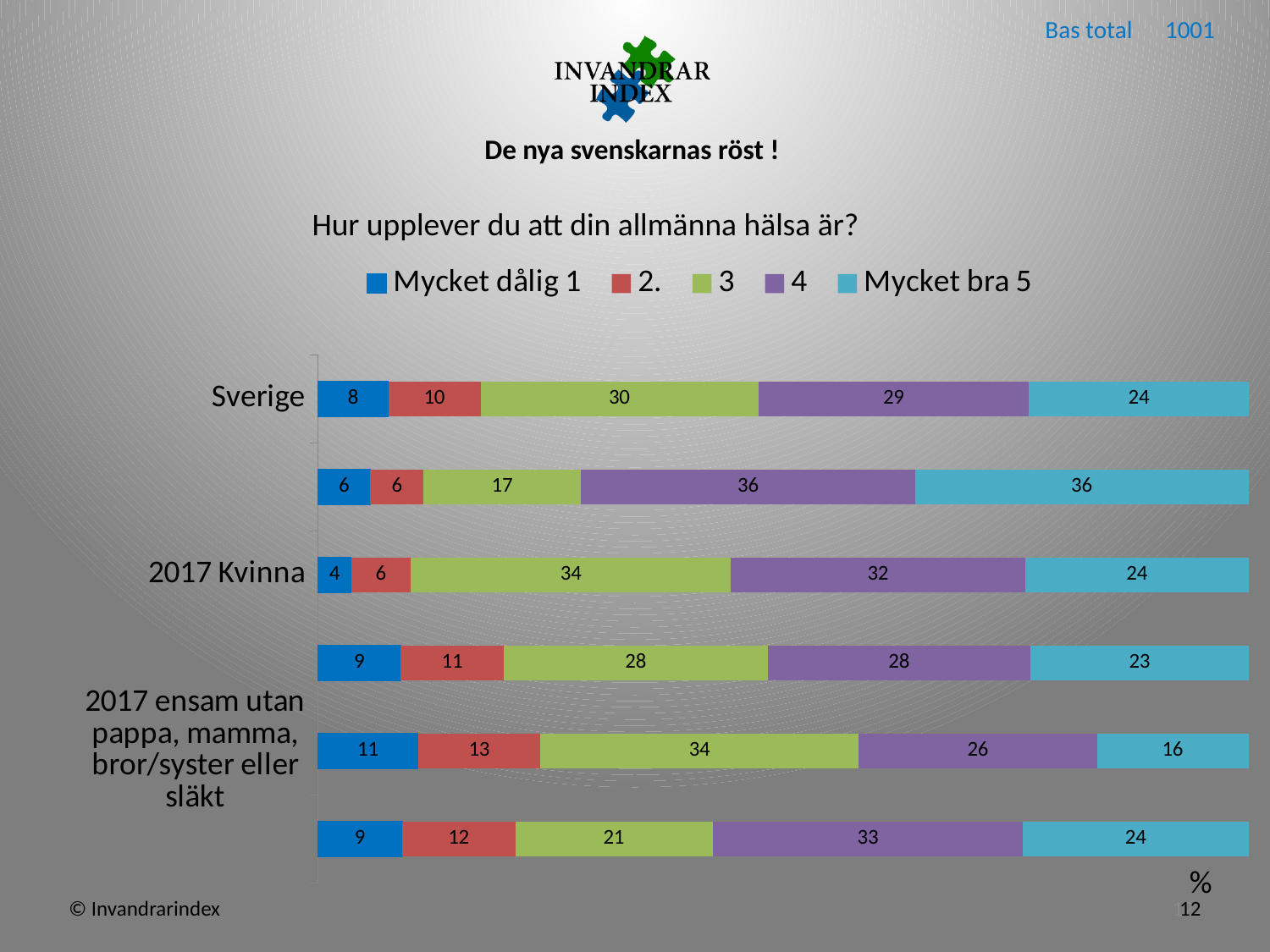
How many series does the legend list? 5 What is the value for 'Mycket dålig 1' in the 2017 Kvinna bar? 4 Which series has the smallest segment in the 2017 Kvinna bar? Mycket dålig 1 Which is larger: the '3' segment for Sverige or the '3' segment for 2017 Kvinna? 2017 Kvinna What is the total of all segments in the 2017 Kvinna bar? 100 What is the difference between the '4' segment and the 'Mycket dålig 1' segment in the Sverige bar? 21 What is the value for series '3' in the Sverige bar? 30 Which series has the largest segment in the Sverige bar? 3 What kind of chart is shown on the slide? Stacked bar chart What is the value for 'Mycket bra 5' in the Sverige bar? 24 How many bars are plotted in the chart? 6 What is the value for series '4' in the 2017 Kvinna bar? 32